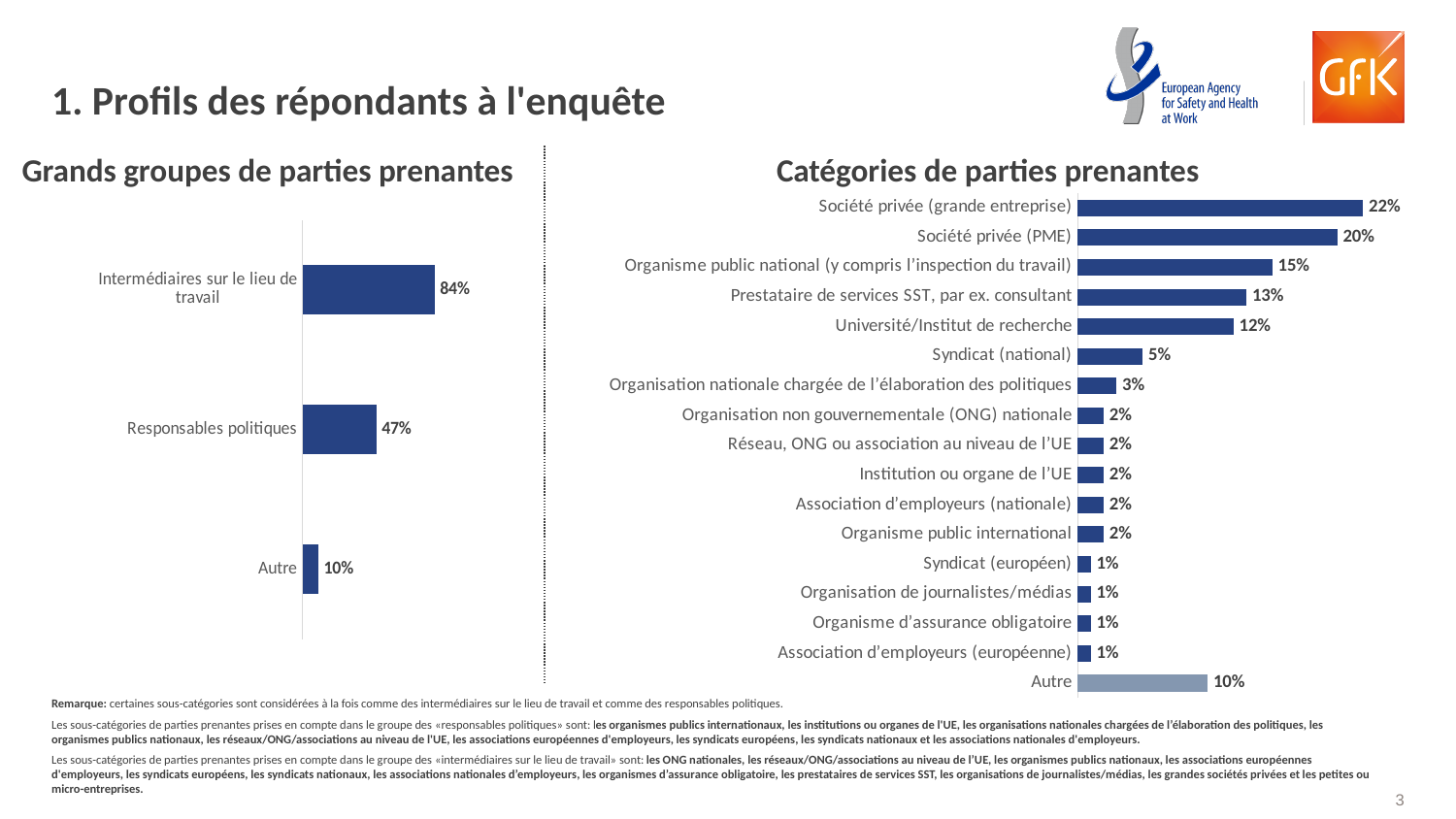
In the chart 'Catégories de parties prenantes', which category has the highest value? Société privée (grande entreprise) In the chart 'Grands groupes de parties prenantes', how many categories are shown? 3 In the chart 'Catégories de parties prenantes', how many categories are shown? 17 What type of chart is 'Catégories de parties prenantes'? Bar chart In the chart 'Catégories de parties prenantes', which is larger: 'Prestataire de services SST, par ex. consultant' or 'Organisme public national (y compris l'inspection du travail)'? Organisme public national (y compris l'inspection du travail) In the chart 'Grands groupes de parties prenantes', what is the difference between 'Intermédiaires sur le lieu de travail' and 'Responsables politiques'? 37% In the chart 'Catégories de parties prenantes', what is the value for 'Société privée (PME)'? 20% In the chart 'Grands groupes de parties prenantes', what is the value for 'Responsables politiques'? 47% In the chart 'Catégories de parties prenantes', what is the value for 'Syndicat (national)'? 5% In the chart 'Grands groupes de parties prenantes', what is the value for 'Intermédiaires sur le lieu de travail'? 84% In the chart 'Catégories de parties prenantes', what is the difference between 'Société privée (grande entreprise)' and 'Société privée (PME)'? 2% In the chart 'Catégories de parties prenantes', what is the value for 'Université/Institut de recherche'? 12%